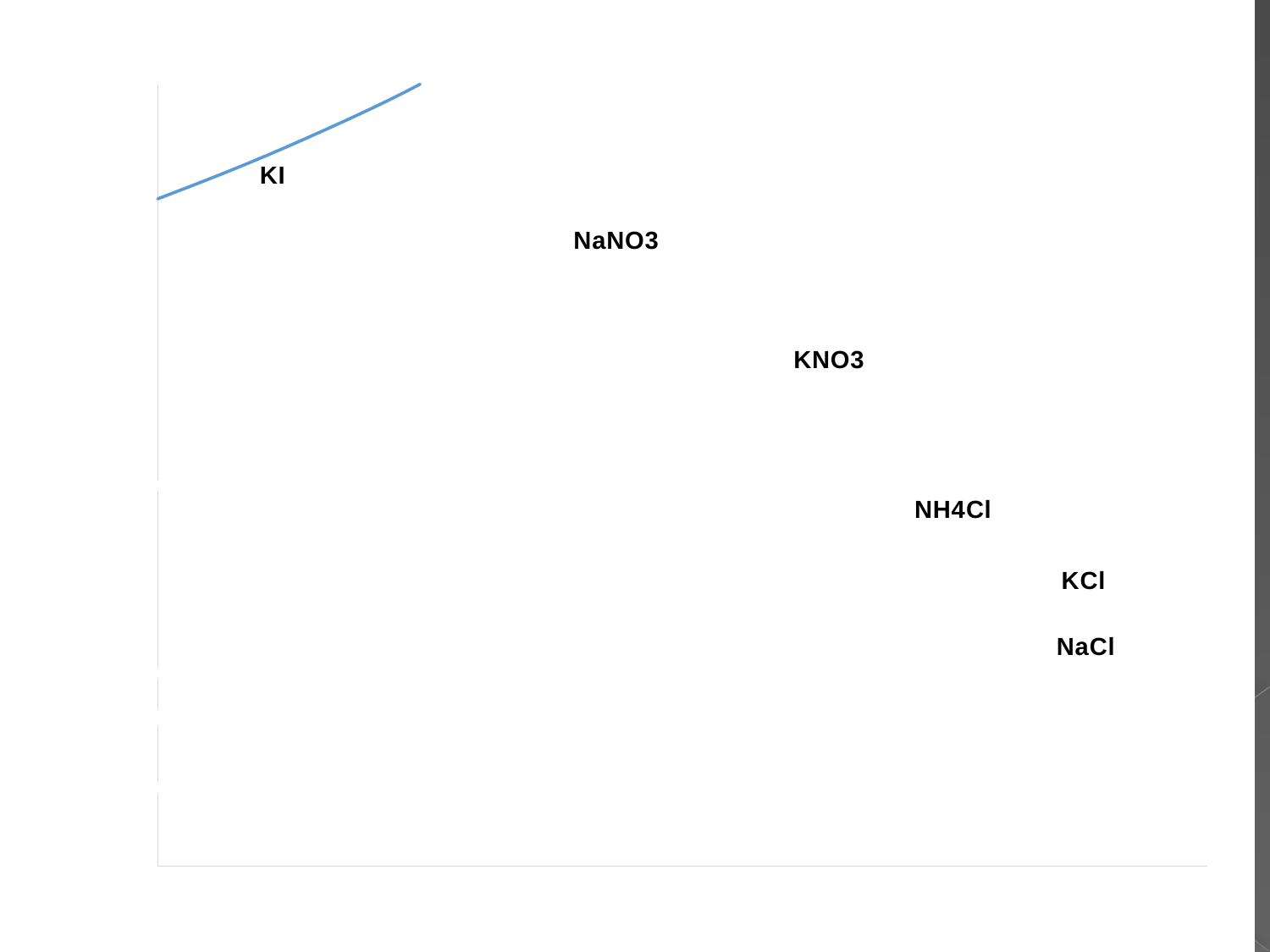
What colour is the plotted line on the chart? blue What kind of chart is shown on the slide? line chart How many substance labels are shown on the chart? 6 Does the KI line rise or fall from left to right? rise Which substance label is placed next to the plotted line? KI